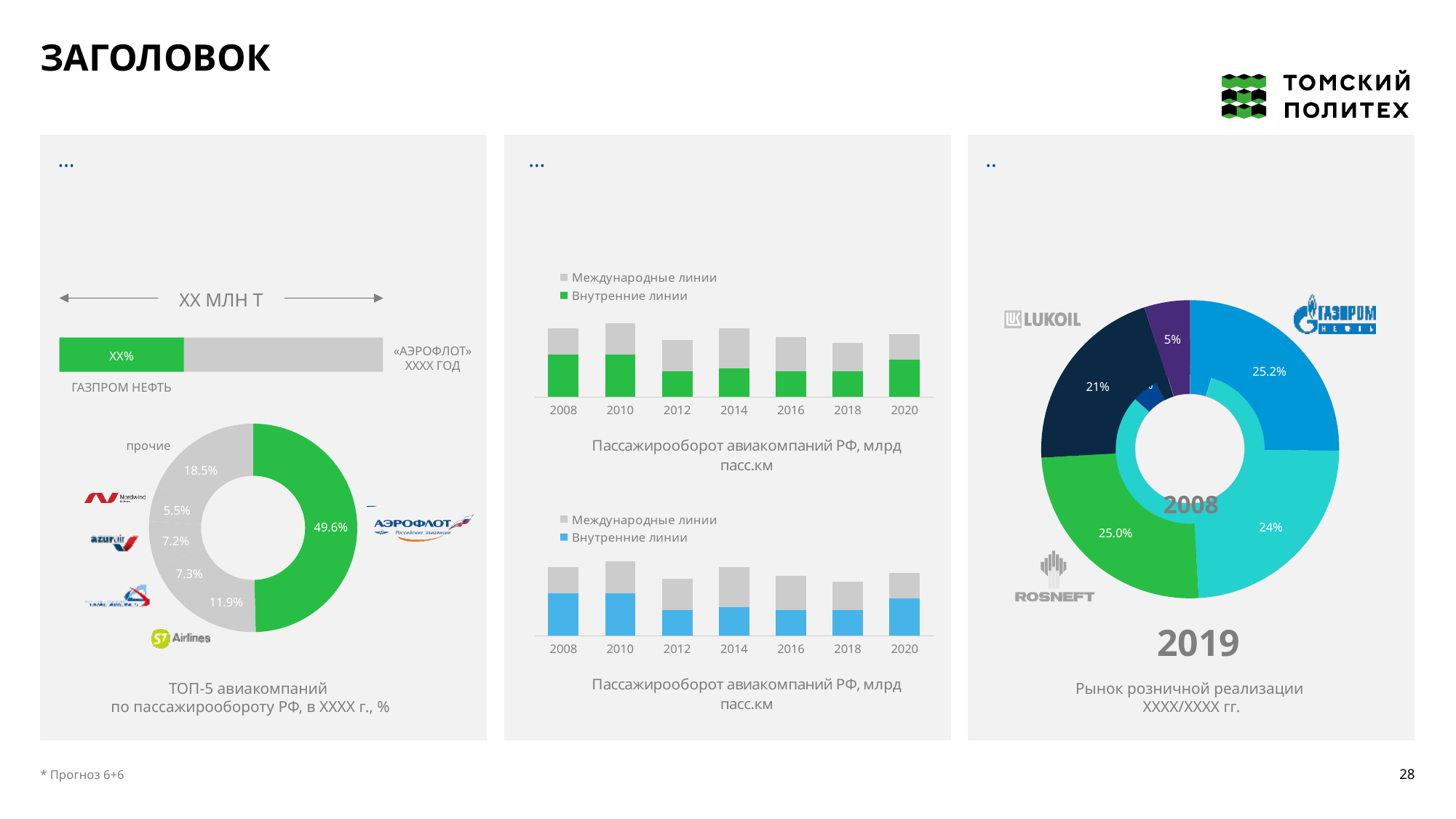
In the left donut chart (ТОП-5 авиакомпаний), which airline has the smallest labeled slice? Nordwind In the left donut chart (ТОП-5 авиакомпаний по пассажирообороту РФ), what share is shown for Аэрофлот? 49.6% In the left donut chart (ТОП-5 авиакомпаний), what share is shown for прочие? 18.5% What type of chart is the lower middle chart (Пассажирооборот авиакомпаний РФ)? Stacked bar chart In the right donut chart (Рынок розничной реализации), what is the smallest percentage labeled on the outer ring? 5% In the left donut chart (ТОП-5 авиакомпаний), how many percentage points larger is Аэрофлот's share than S7 Airlines' share? 37.7 In the left donut chart (ТОП-5 авиакомпаний), which airline has the largest slice? Аэрофлот In the upper middle chart (Пассажирооборот авиакомпаний РФ), how many series does the legend list? 2 In the right donut chart (Рынок розничной реализации), what share is labeled for the Газпром нефть slice? 25.2% In the left donut chart (ТОП-5 авиакомпаний), what share is shown for S7 Airlines? 11.9% In the upper middle chart (Пассажирооборот авиакомпаний РФ), how many years are shown on the x axis? 7 In the upper middle chart (Пассажирооборот авиакомпаний РФ), what are the two legend entries? Международные линии, Внутренние линии